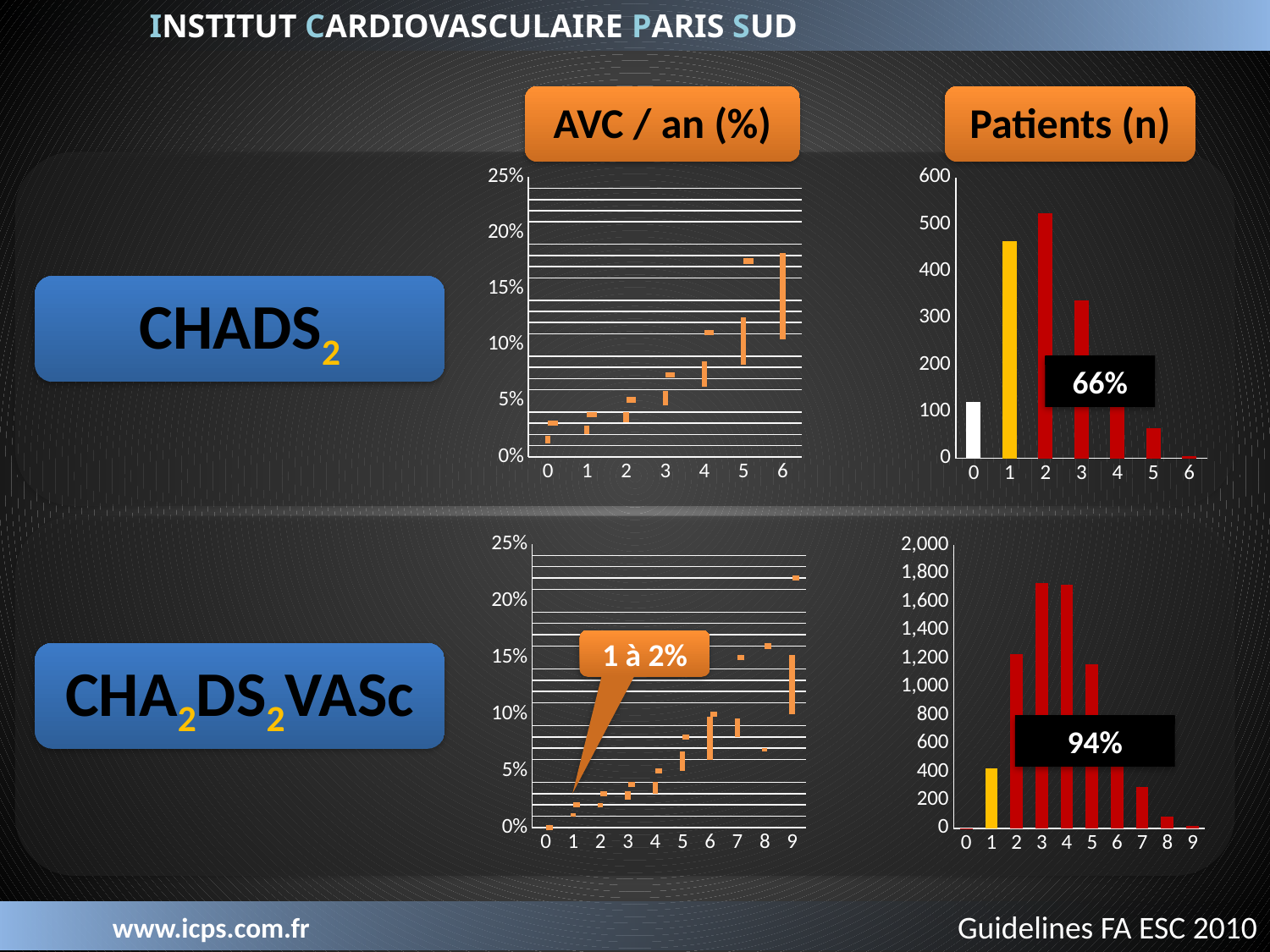
In the top-right Patients (n) chart for CHADS2, which score category has the tallest bar? 2 How many score categories are shown on the x axis of the top-right Patients (n) chart for CHADS2? 7 In the bottom-right Patients (n) chart for CHA2DS2VASc, which is larger, the bar for score 2 or the bar for score 6? score 2 In the top-right Patients (n) chart for CHADS2, is the value for score 1 greater or less than 400? greater In the bottom-right Patients (n) chart for CHA2DS2VASc, is the value for score 3 greater or less than 1,600? greater In the bottom-right Patients (n) chart for CHA2DS2VASc, is the value for score 7 greater or less than 400? less In the top-left AVC / an (%) chart for CHADS2, do the values generally rise or fall as the score increases from 0 to 6? rise How many score categories are shown on the x axis of the bottom-right Patients (n) chart for CHA2DS2VASc? 10 In the top-right Patients (n) chart for CHADS2, which is larger, the bar for score 3 or the bar for score 4? score 3 What percentage is printed in the black label on the top-right Patients (n) chart for CHADS2? 66%